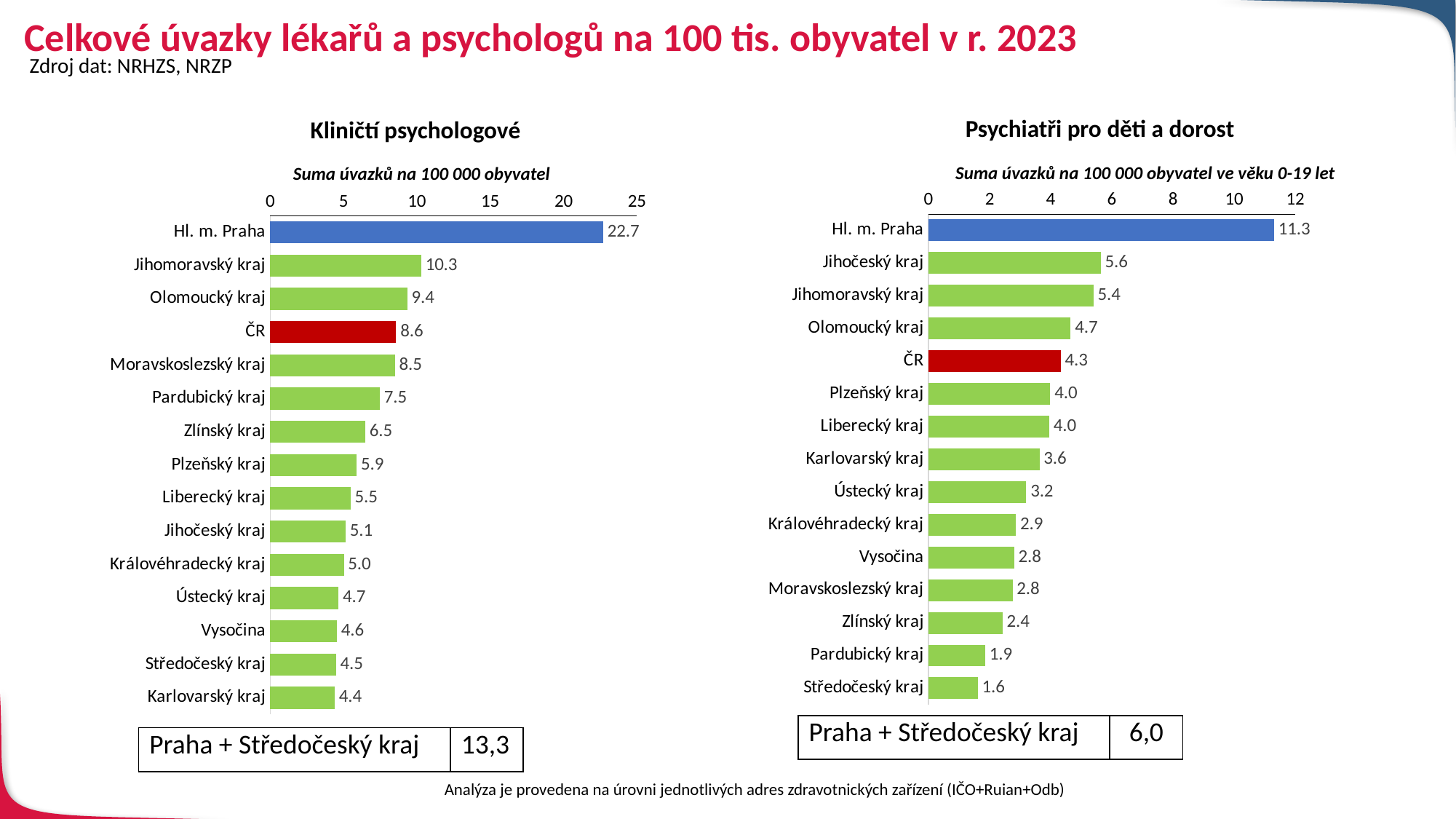
In the 'Kliničtí psychologové' chart, what is the value for Hl. m. Praha? 22.7 How many categories are shown in the 'Kliničtí psychologové' chart? 15 What kind of chart is the 'Psychiatři pro děti a dorost' chart? bar chart In the 'Psychiatři pro děti a dorost' chart, what is the value for Jihočeský kraj? 5.6 In the 'Kliničtí psychologové' chart, which is larger, Olomoucký kraj or Pardubický kraj? Olomoucký kraj In the 'Psychiatři pro děti a dorost' chart, what is the value for Středočeský kraj? 1.6 In the 'Kliničtí psychologové' chart, what is the value for ČR? 8.6 In the 'Kliničtí psychologové' chart, which category has the lowest value? Karlovarský kraj In the 'Psychiatři pro děti a dorost' chart, what is the difference between ČR and Pardubický kraj? 2.4 In the 'Psychiatři pro děti a dorost' chart, which category has the highest value? Hl. m. Praha In the 'Kliničtí psychologové' chart, what is the difference between Hl. m. Praha and Jihomoravský kraj? 12.4 In the 'Psychiatři pro děti a dorost' chart, is the value for Olomoucký kraj greater or less than 4? greater